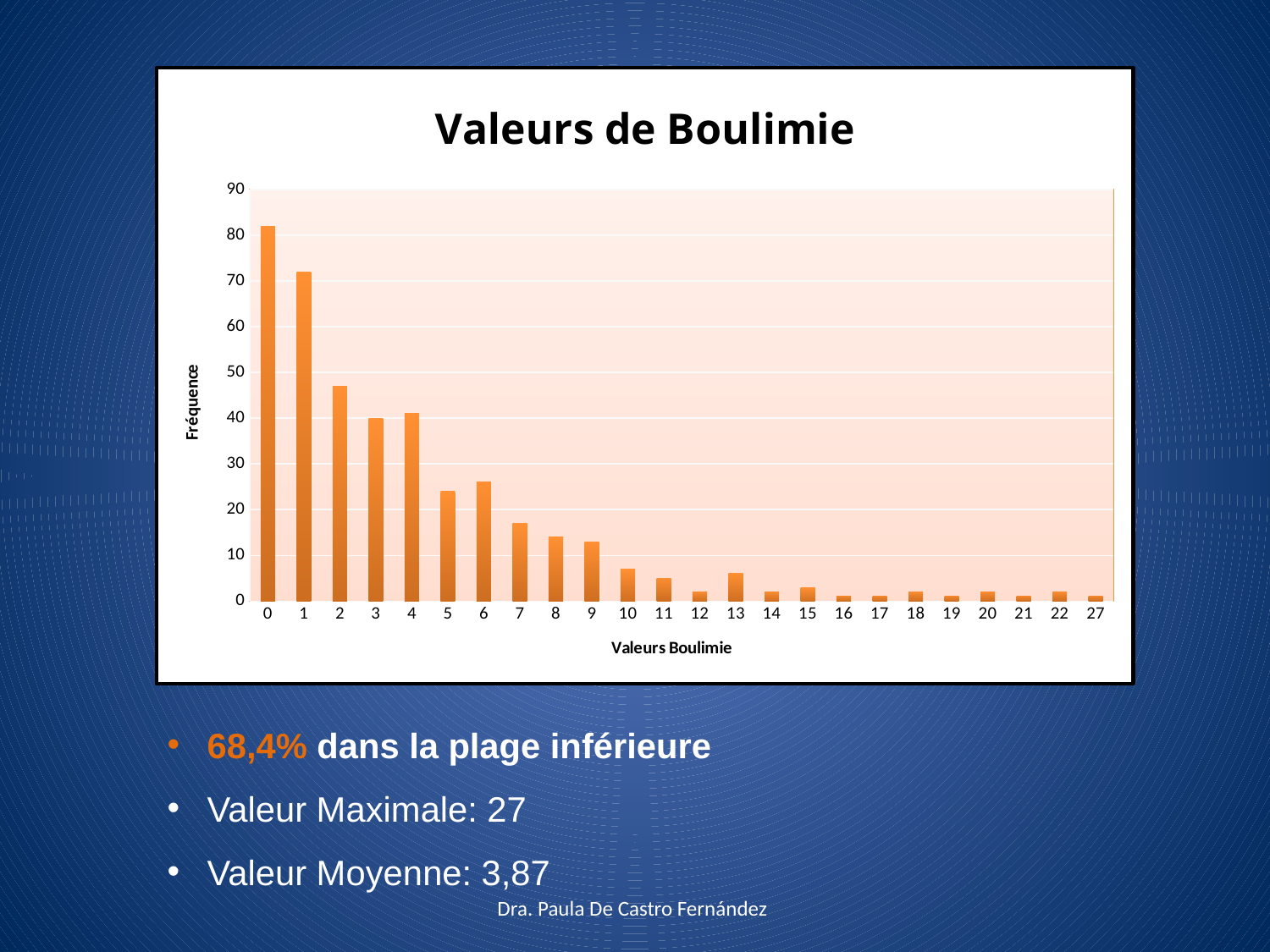
Is the frequency for category 0 greater or less than 80? greater Which has a higher frequency, category 1 or category 2? 1 What is the label of the y axis of the chart? Fréquence Is the frequency for category 1 greater or less than 70? greater Is the frequency for category 10 greater or less than 10? less Which category has the highest frequency in the chart? 0 What type of chart is shown on the slide? bar chart How many categories are shown on the x axis of the chart? 24 What is the title of the chart? Valeurs de Boulimie Which has a higher frequency, category 7 or category 13? 7